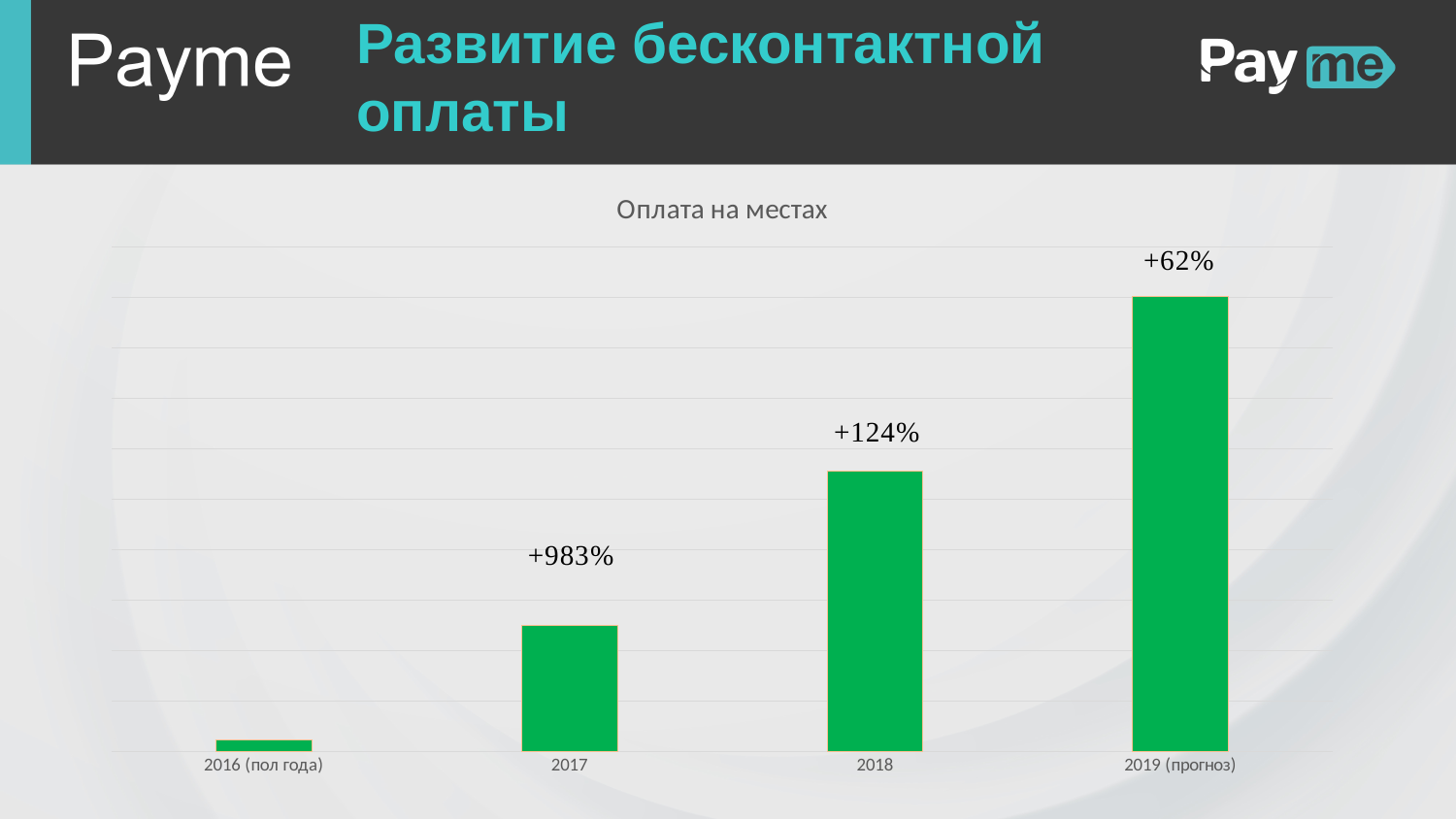
Which category has the largest printed growth percentage? 2017 What growth label is printed above the bar for 2017? +983% Which category has the shortest bar? 2016 (пол года) What is the title of the chart? Оплата на местах Which bar is taller, 2017 or 2018? 2018 What growth label is printed above the bar for 2019 (прогноз)? +62% What colour are the bars in the chart? green Which category has the tallest bar? 2019 (прогноз) What growth label is printed above the bar for 2018? +124% How many categories are shown on the x axis of the chart? 4 Do the bar heights rise or fall from 2016 to 2019? rise What kind of chart is shown on the slide? bar chart